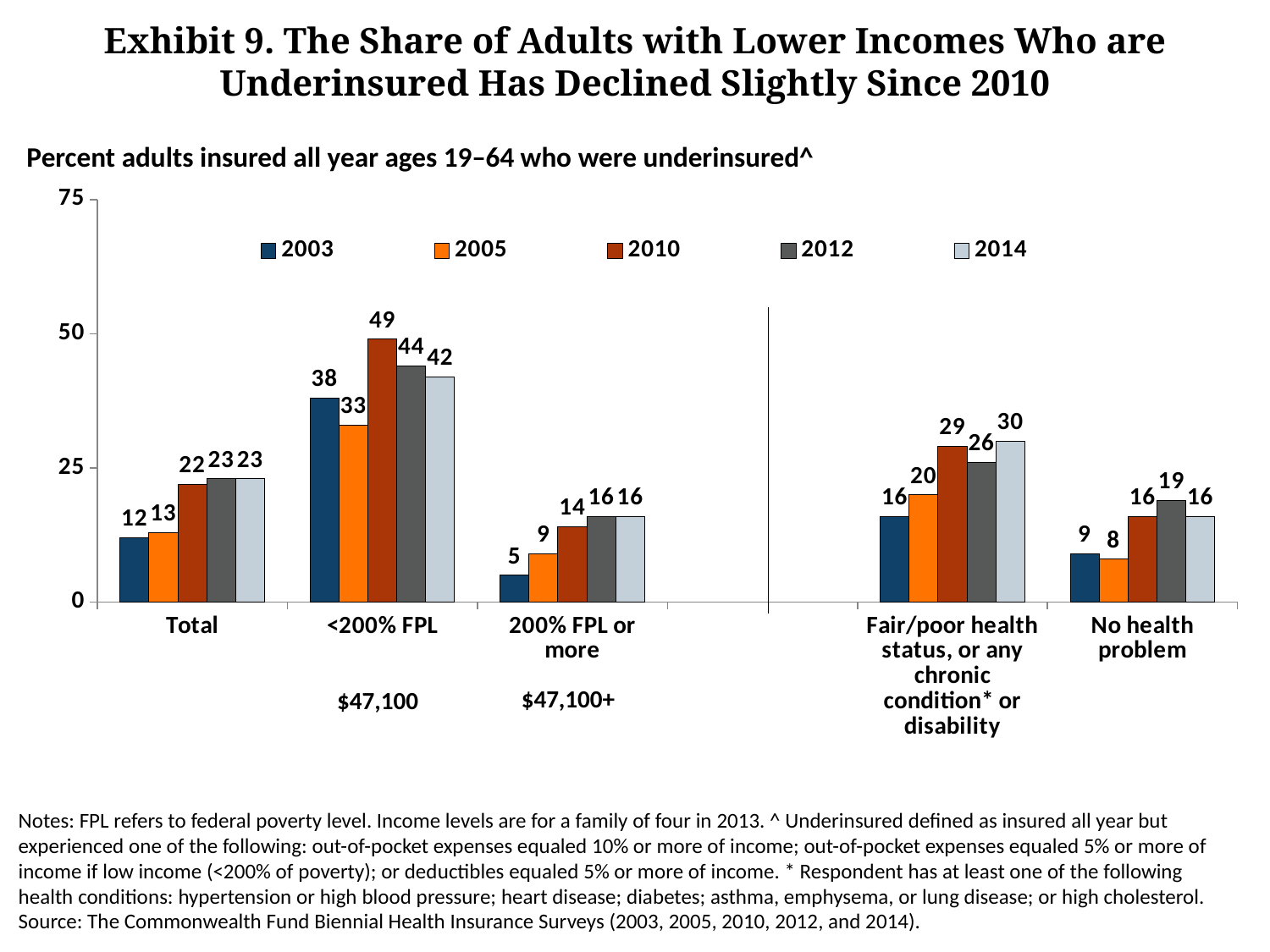
What kind of chart is shown on the slide? bar chart What is the difference between the 2010 and 2014 values for <200% FPL? 7 How many series does the legend list? 5 How many categories are shown on the x axis? 5 What is the value for <200% FPL in 2010? 49 Which is larger: the 2003 value for Total or the 2003 value for Fair/poor health status, or any chronic condition or disability? Fair/poor health status, or any chronic condition or disability Which category has the lowest value in 2005? No health problem Is the 2012 value for <200% FPL greater or less than 25? greater Which category has the highest value in 2014? <200% FPL What is the income level shown beneath the <200% FPL category? $47,100 What is the value for No health problem in 2012? 19 What is the value for 200% FPL or more in 2003? 5